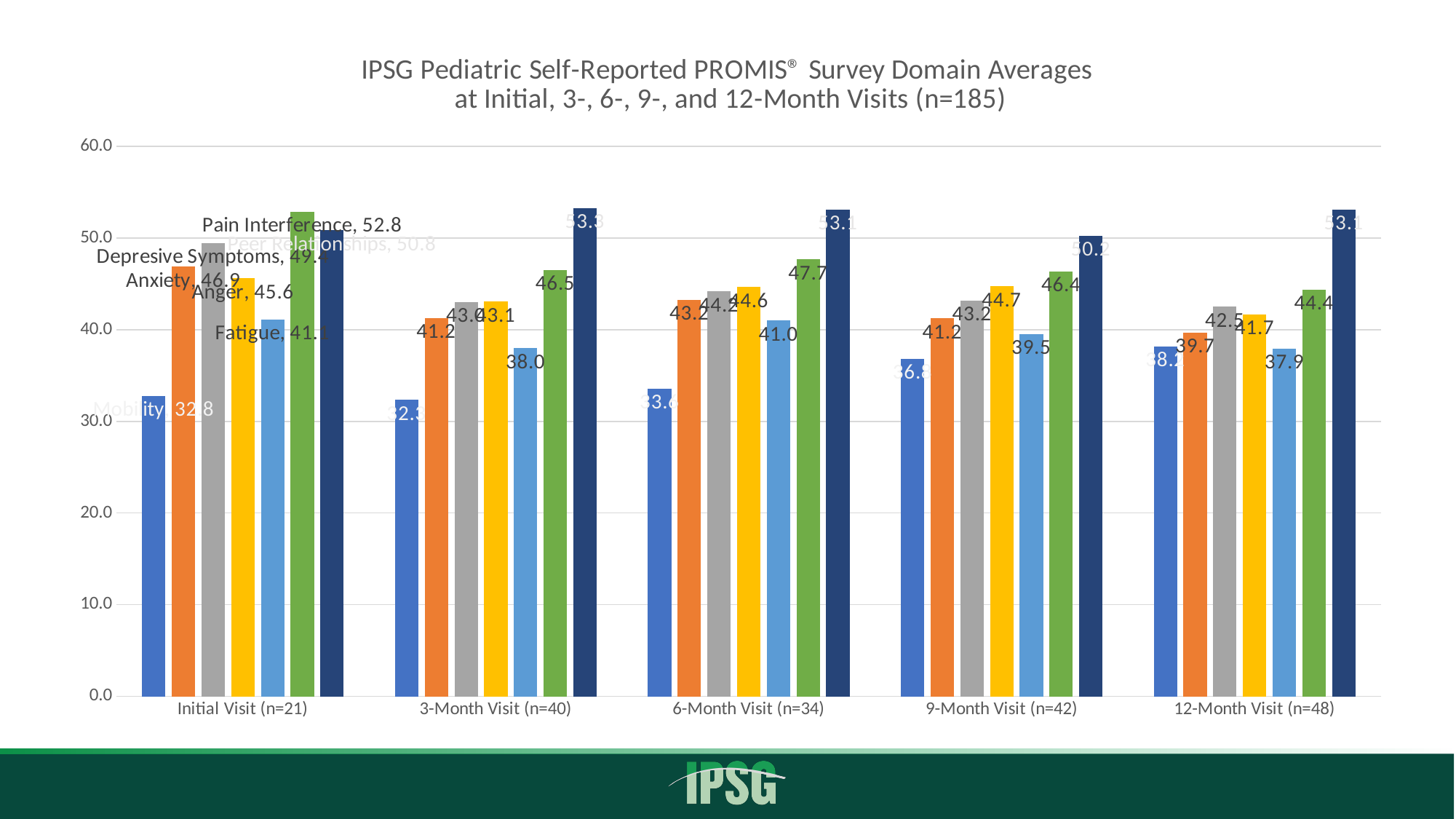
Which domain has the lowest average at the Initial Visit? Mobility Is the value of the first (blue) bar in the 9-Month Visit (n=42) group greater or less than 40? less Does the first (blue) bar in each group rise or fall from the 3-Month Visit to the 12-Month Visit? Rises Which domain has the highest average at the Initial Visit? Pain Interference What is the Fatigue average at the Initial Visit? 41.1 What kind of chart is shown on the slide? Bar chart What is the value of the tallest bar in the 3-Month Visit (n=40) group? 53.3 What is the difference between the Pain Interference and Mobility averages at the Initial Visit? 20.0 How many visit categories are shown along the x axis? 5 At the Initial Visit, which is larger: the Anxiety average or the Anger average? Anxiety What is the Pain Interference average at the Initial Visit? 52.8 What is the Mobility average at the Initial Visit? 32.8